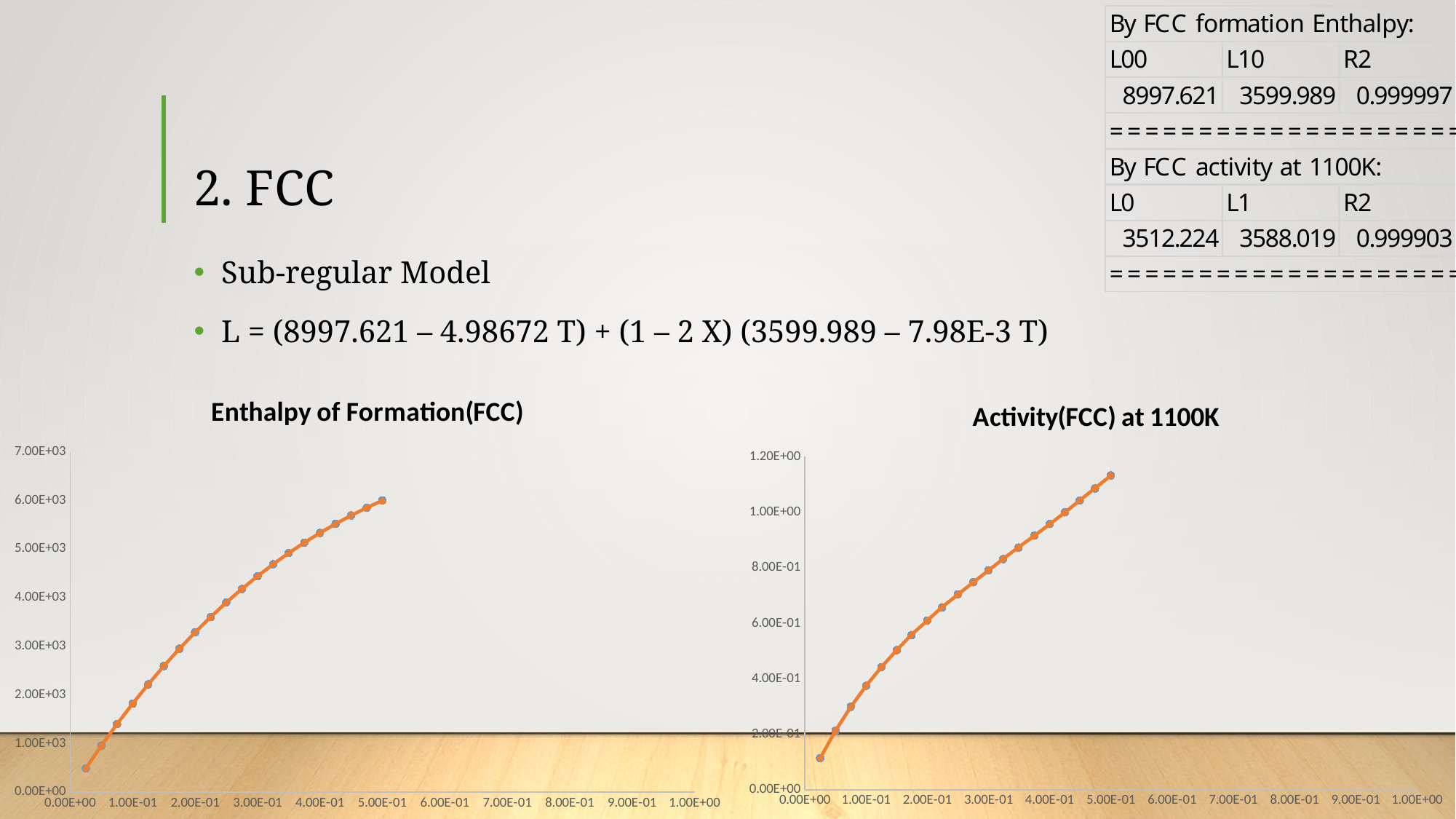
What is the highest tick label on the y axis of the "Enthalpy of Formation(FCC)" chart? 7.00E+03 What is the title of the chart on the right side of the slide? Activity(FCC) at 1100K In the "Enthalpy of Formation(FCC)" chart, is the value at x = 1.00E-01 greater or less than 2.00E+03? less In the "Enthalpy of Formation(FCC)" chart, is the value at x = 5.00E-01 greater or less than 5.00E+03? greater In the "Activity(FCC) at 1100K" chart, do the values rise or fall as x increases? rise In the "Activity(FCC) at 1100K" chart, is the value at x = 5.00E-01 greater or less than 1.00E+00? greater What kind of chart is the "Activity(FCC) at 1100K" chart? line chart In the "Enthalpy of Formation(FCC)" chart, do the values rise or fall as x increases? rise What kind of chart is the "Enthalpy of Formation(FCC)" chart? line chart In the "Activity(FCC) at 1100K" chart, which x value has the larger plotted value, 1.00E-01 or 5.00E-01? 5.00E-01